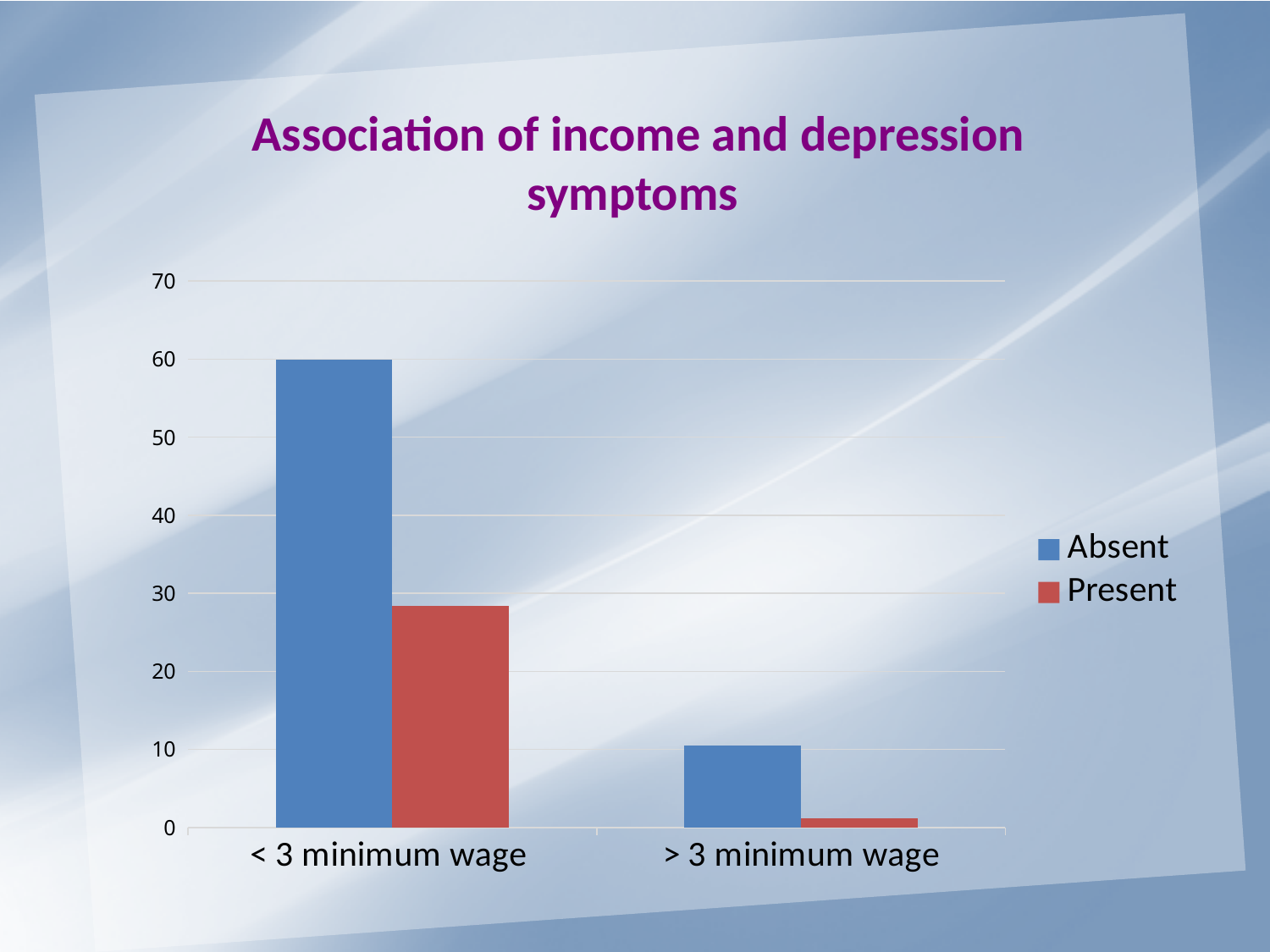
For < 3 minimum wage, which is larger: Absent or Present? Absent How many series does the legend list? 2 Which bar is the highest in the chart? Absent for < 3 minimum wage What is the title of the chart? Association of income and depression symptoms Is the value for Present in the < 3 minimum wage category greater or less than 30? less What kind of chart is shown on the slide? bar chart Does the Absent series rise or fall from < 3 minimum wage to > 3 minimum wage? fall How many income categories are shown on the x axis? 2 Which bar is the lowest in the chart? Present for > 3 minimum wage Is the value for Present in the > 3 minimum wage category greater or less than 10? less